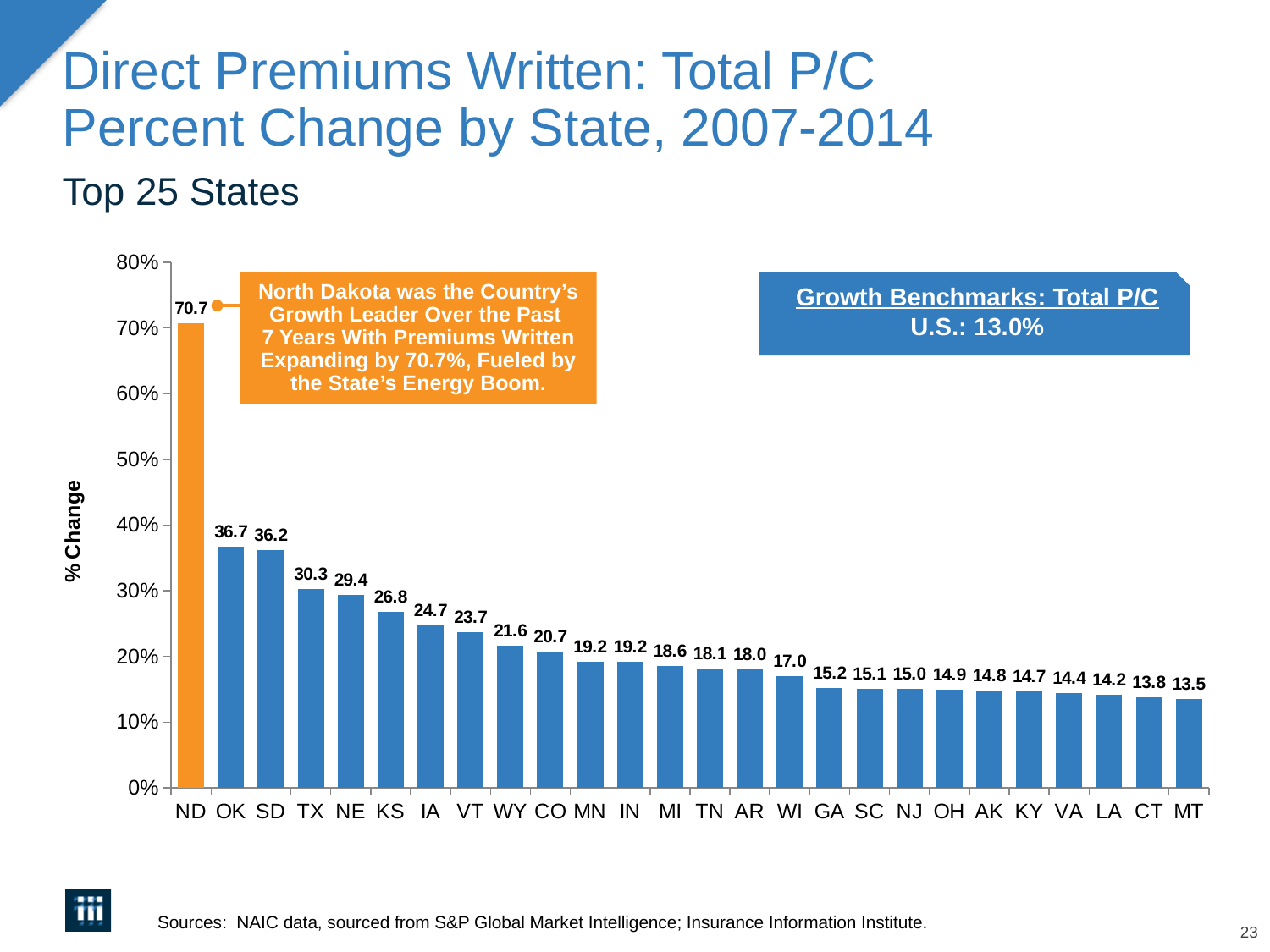
What is the percent change for TX? 30.3 What kind of chart is shown? Bar chart What is the U.S. growth benchmark for Total P/C shown on the slide? 13.0% Which state has the highest percent change? ND What is the difference between the percent change for ND and OK? 34.0 Which has a larger percent change, KS or IA? KS How many states are shown on the chart? 26 What is the percent change for MT? 13.5 Which state has the lowest percent change among those shown? MT What is the difference between the percent change for OK and SD? 0.5 Do the values rise or fall moving from left to right along the x axis? Fall What is the percent change for ND? 70.7